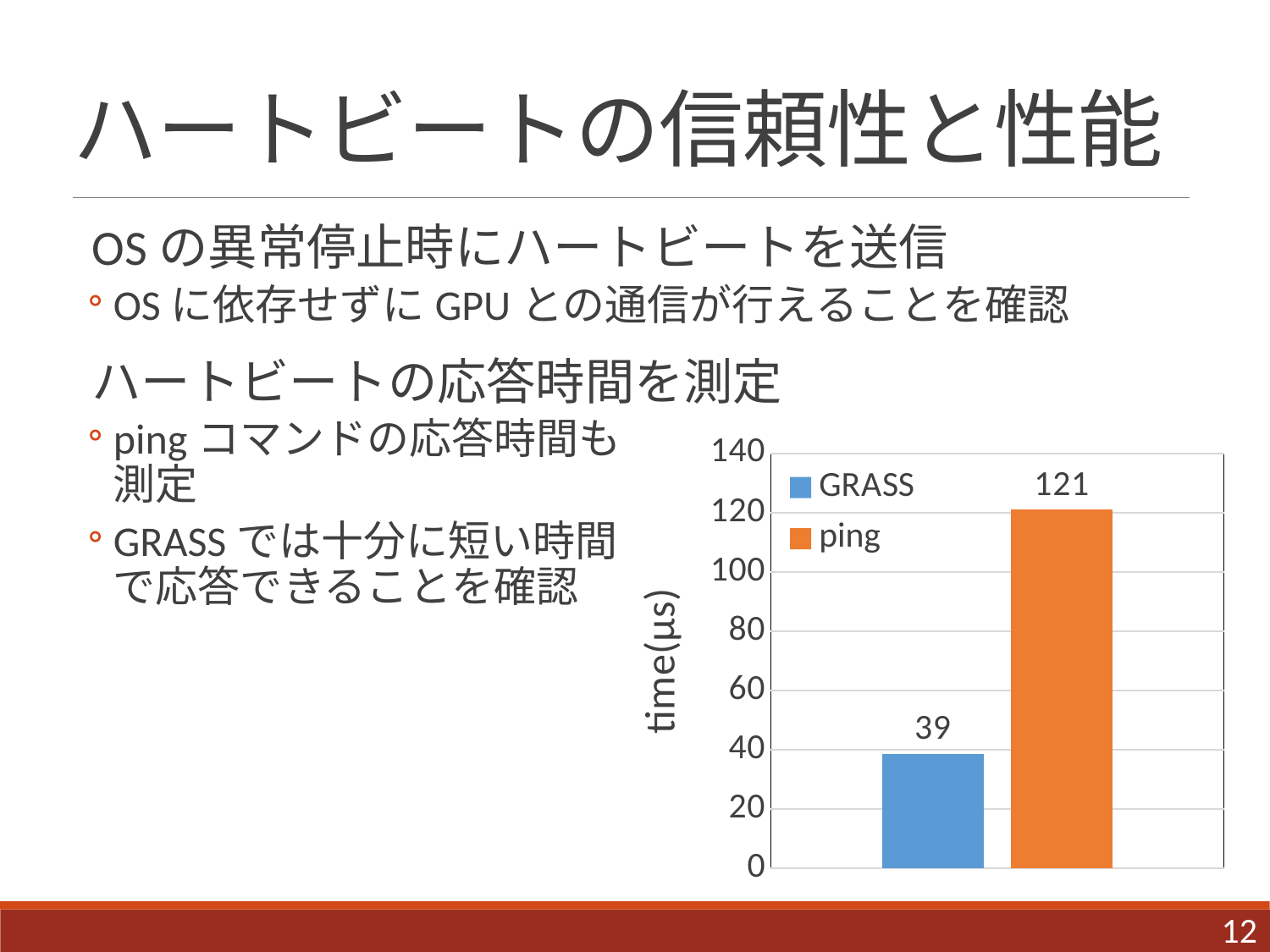
Is the value for GRASS greater or less than 60? less Which series has the highest value? ping What kind of chart is shown on the slide? bar chart Which series has the lowest value? GRASS What colour is the bar for ping? orange What is the value for ping? 121 What is the value for GRASS? 39 What is the label of the vertical axis? time(μs) What is the difference between the ping value and the GRASS value? 82 How many series does the legend list? 2 Which is larger, the value for GRASS or the value for ping? ping Is the value for ping greater or less than 100? greater